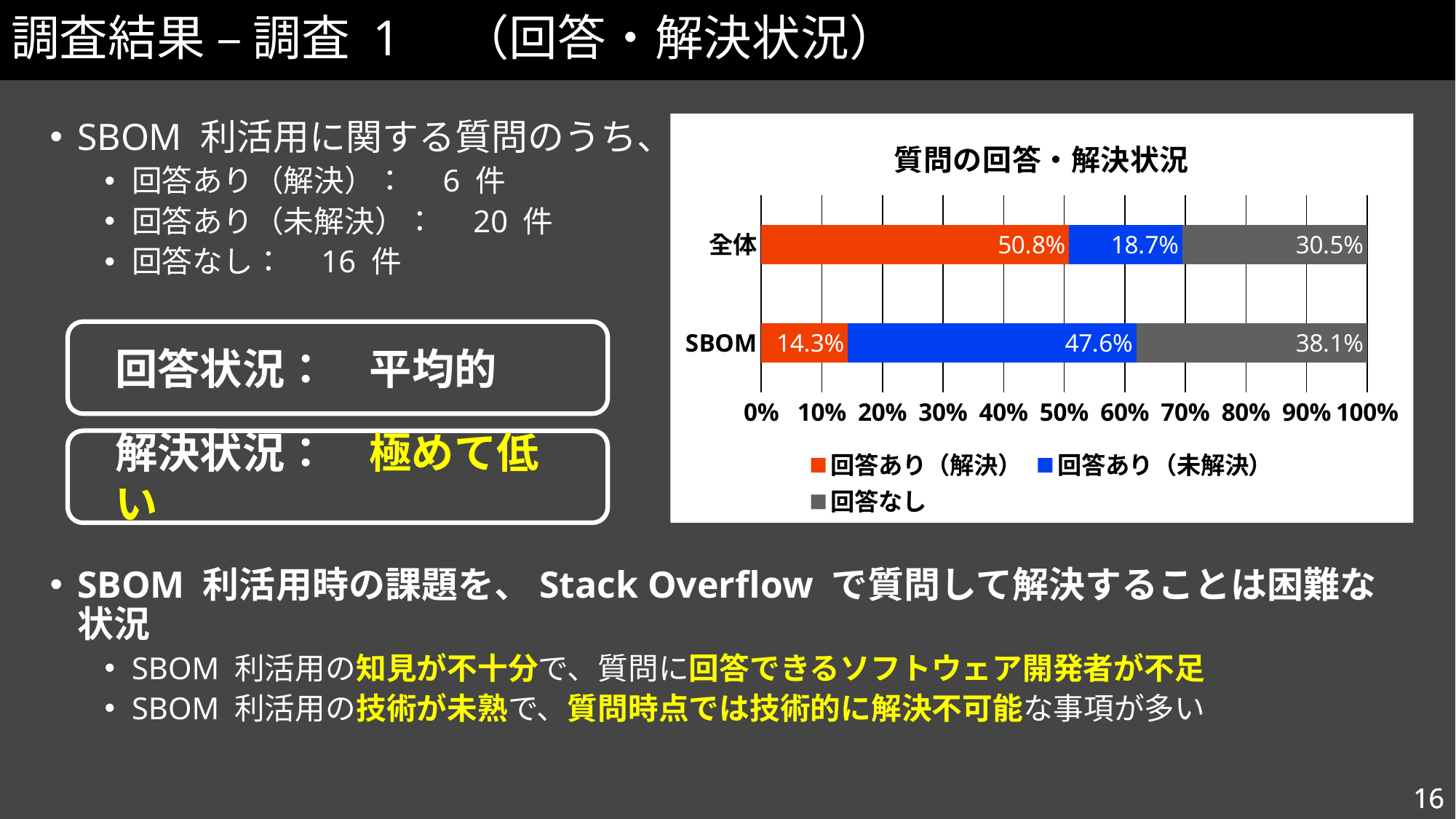
What is the value of 回答あり（未解決） for SBOM? 47.6% What is the difference between the 回答あり（解決） values for 全体 and SBOM? 36.5% What is the difference between the 回答なし values for SBOM and 全体? 7.6% What is the value of 回答あり（解決） for 全体? 50.8% Which series has the largest value in the SBOM bar? 回答あり（未解決） What type of chart is shown on the slide? Stacked bar chart What is the value of 回答あり（解決） for SBOM? 14.3% What is the value of 回答なし for 全体? 30.5% How many series does the legend list? 3 Which category has the higher value for 回答なし, 全体 or SBOM? SBOM How many categories are shown on the chart? 2 Which category has the higher value for 回答あり（解決）, 全体 or SBOM? 全体